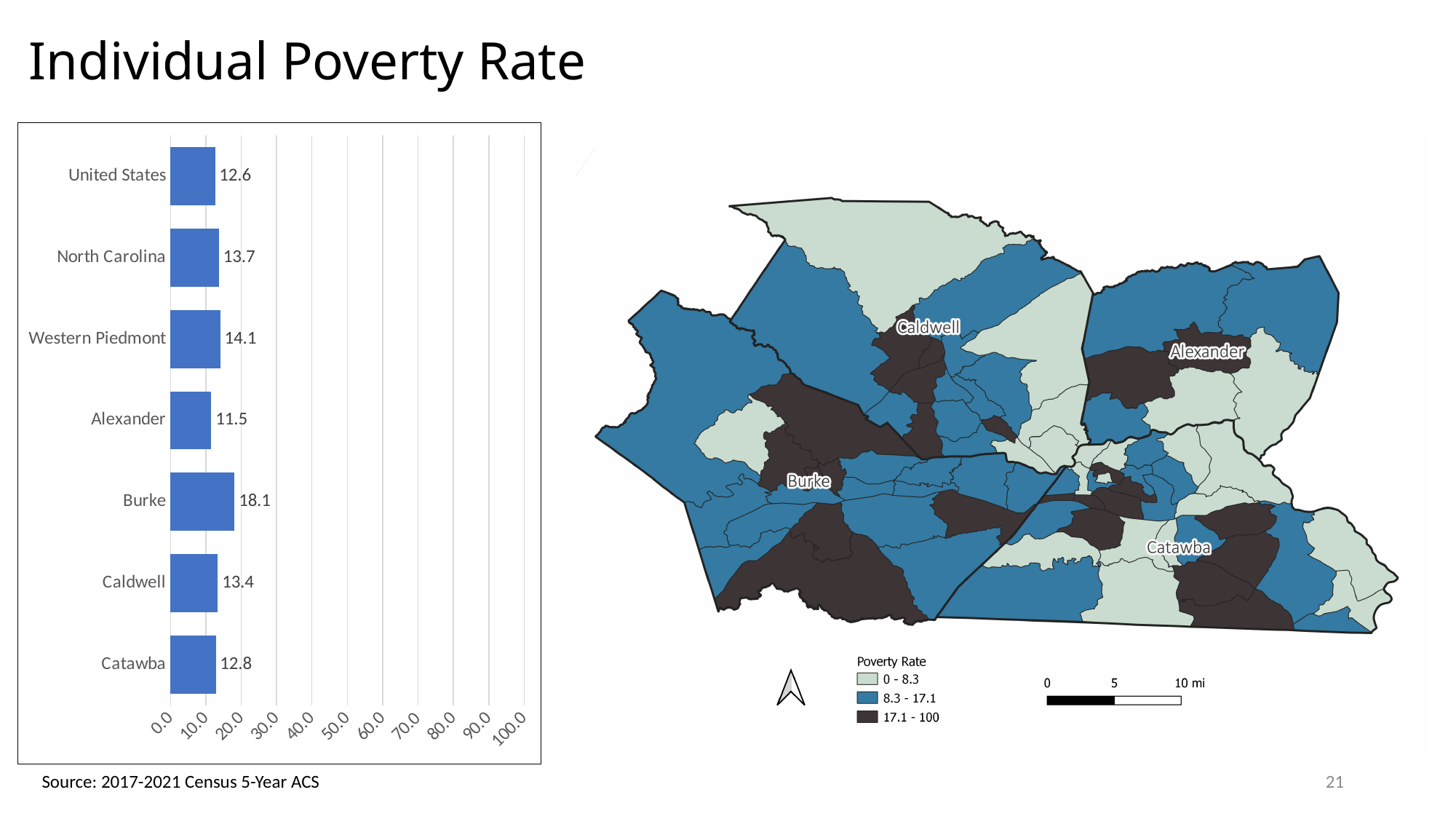
What is the difference between the poverty rates of Burke and Alexander? 6.6 What kind of chart is shown on the left of the slide? Bar chart Is the value for Burke greater or less than 20.0? less What is the individual poverty rate for Burke? 18.1 What is the difference between the poverty rates of North Carolina and the United States? 1.1 Which has a higher poverty rate, Caldwell or Catawba? Caldwell Which category has the lowest individual poverty rate? Alexander What is the individual poverty rate for the United States? 12.6 Which category has the highest individual poverty rate? Burke What is the maximum value shown on the x axis of the bar chart? 100.0 What is the individual poverty rate for Western Piedmont? 14.1 How many categories are shown in the bar chart? 7